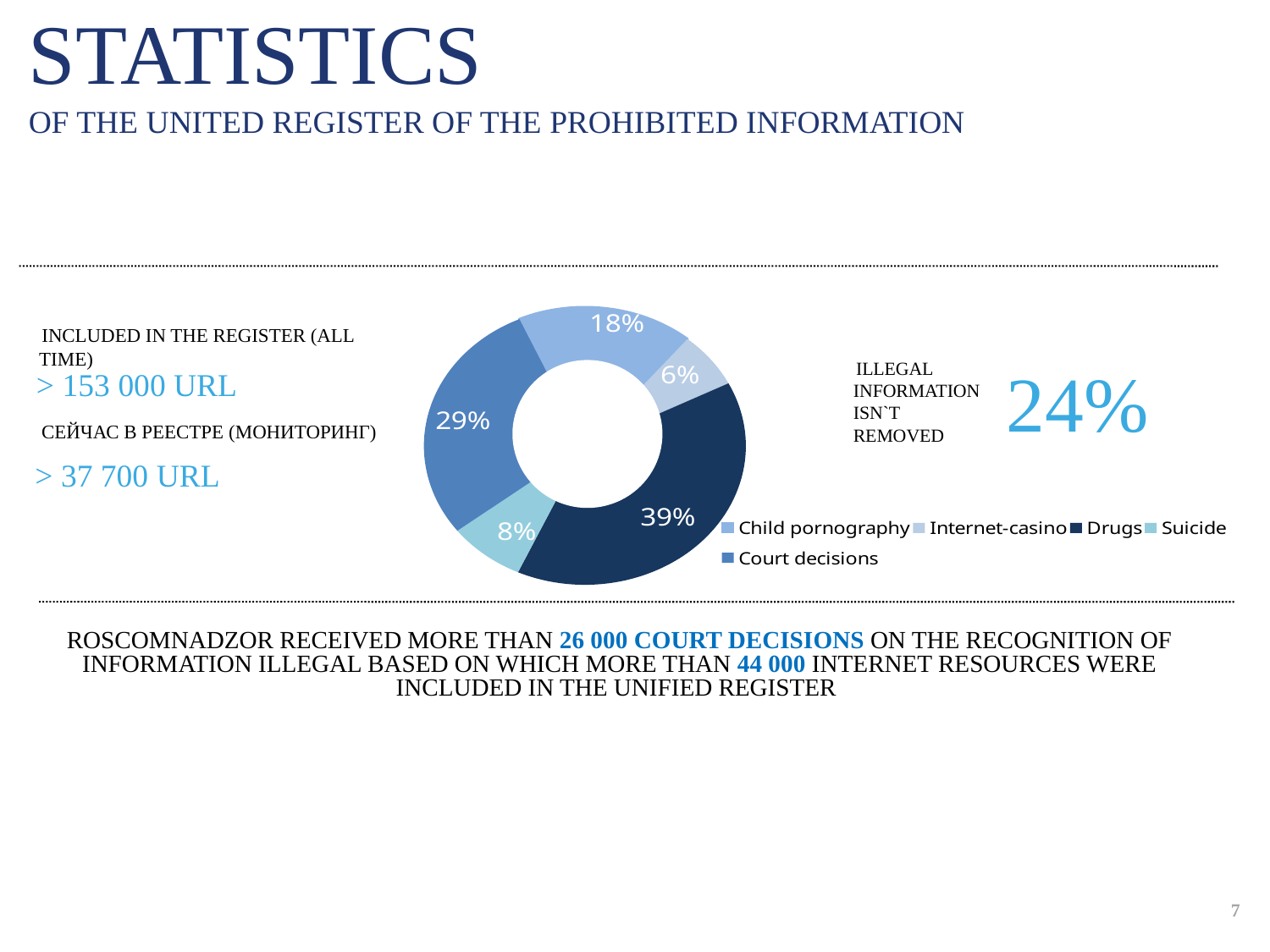
Which category has the largest share of the doughnut chart? Drugs What percentage of the doughnut chart is Court decisions? 29% Which category has the smallest share of the doughnut chart? Internet-casino Which share is larger in the doughnut chart, Child pornography or Suicide? Child pornography What kind of chart is shown on the slide? Doughnut (pie) chart What percentage of the doughnut chart is Internet-casino? 6% What percentage of the doughnut chart is Suicide? 8% What percentage of the doughnut chart is Child pornography? 18% What percentage of the doughnut chart is Drugs? 39% How many percentage points larger is the Drugs share than the Court decisions share? 10 percentage points How many categories does the doughnut chart show? 5 Which categories are listed in the legend of the doughnut chart? Child pornography, Internet-casino, Drugs, Suicide, Court decisions